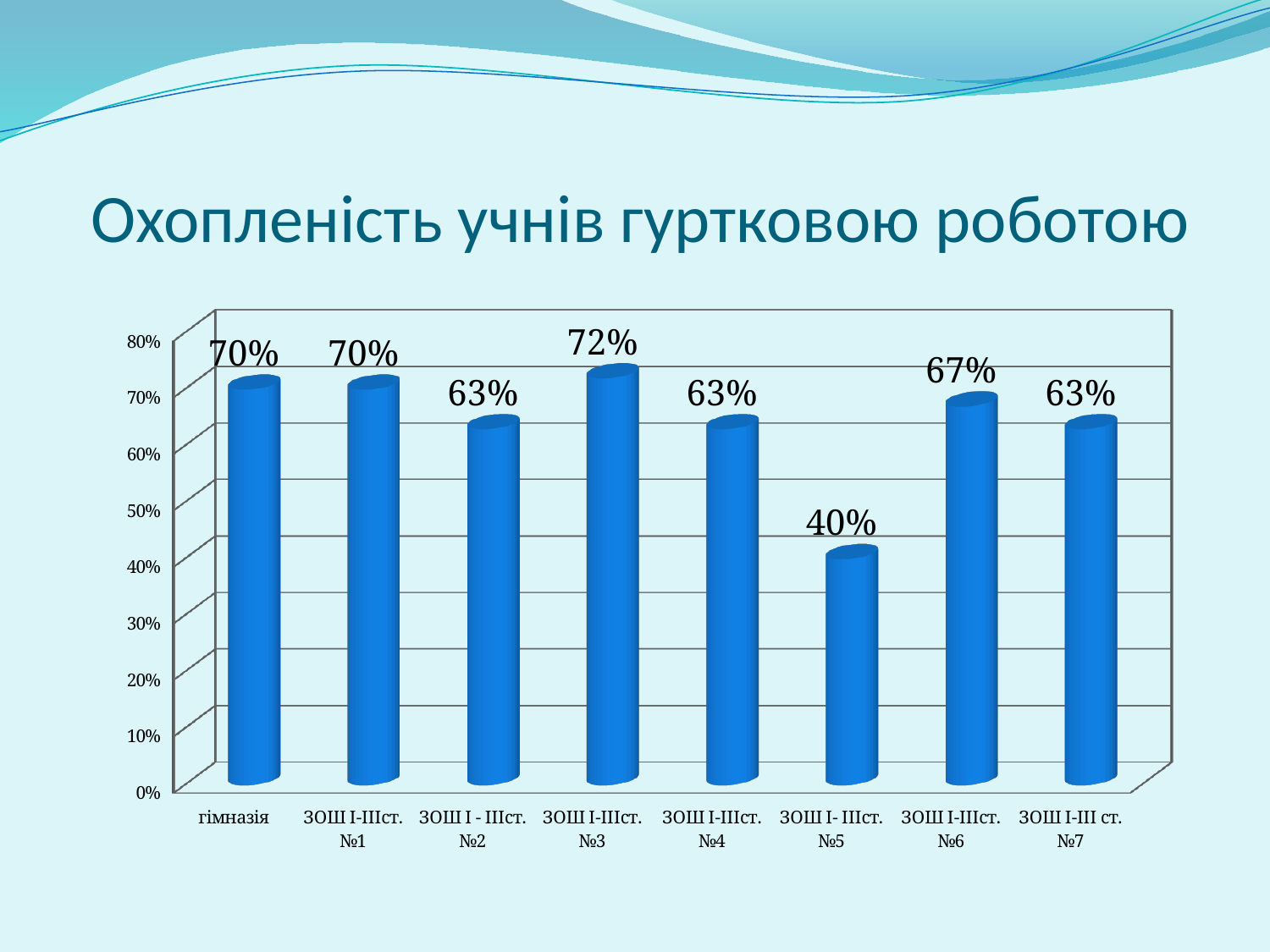
Which category has the highest value? ЗОШ І-ІІІст. №3 What is the title of the slide? Охопленість учнів гуртковою роботою What is the value for ЗОШ І-ІІІст. №6? 67% Which is larger, the value for ЗОШ І-ІІІст. №6 or the value for ЗОШ І-ІІІст. №7? ЗОШ І-ІІІст. №6 What is the difference between the values for ЗОШ І-ІІІст. №3 and ЗОШ І-ІІІст. №5? 32% How many categories are shown on the chart? 8 What kind of chart is shown on the slide? bar chart Is the value for ЗОШ І-ІІІст. №5 greater or less than 50%? less What is the value for ЗОШ І-ІІІст. №5? 40% What is the value for гімназія? 70% What is the value for ЗОШ І-ІІІст. №3? 72% Which category has the lowest value? ЗОШ І-ІІІст. №5